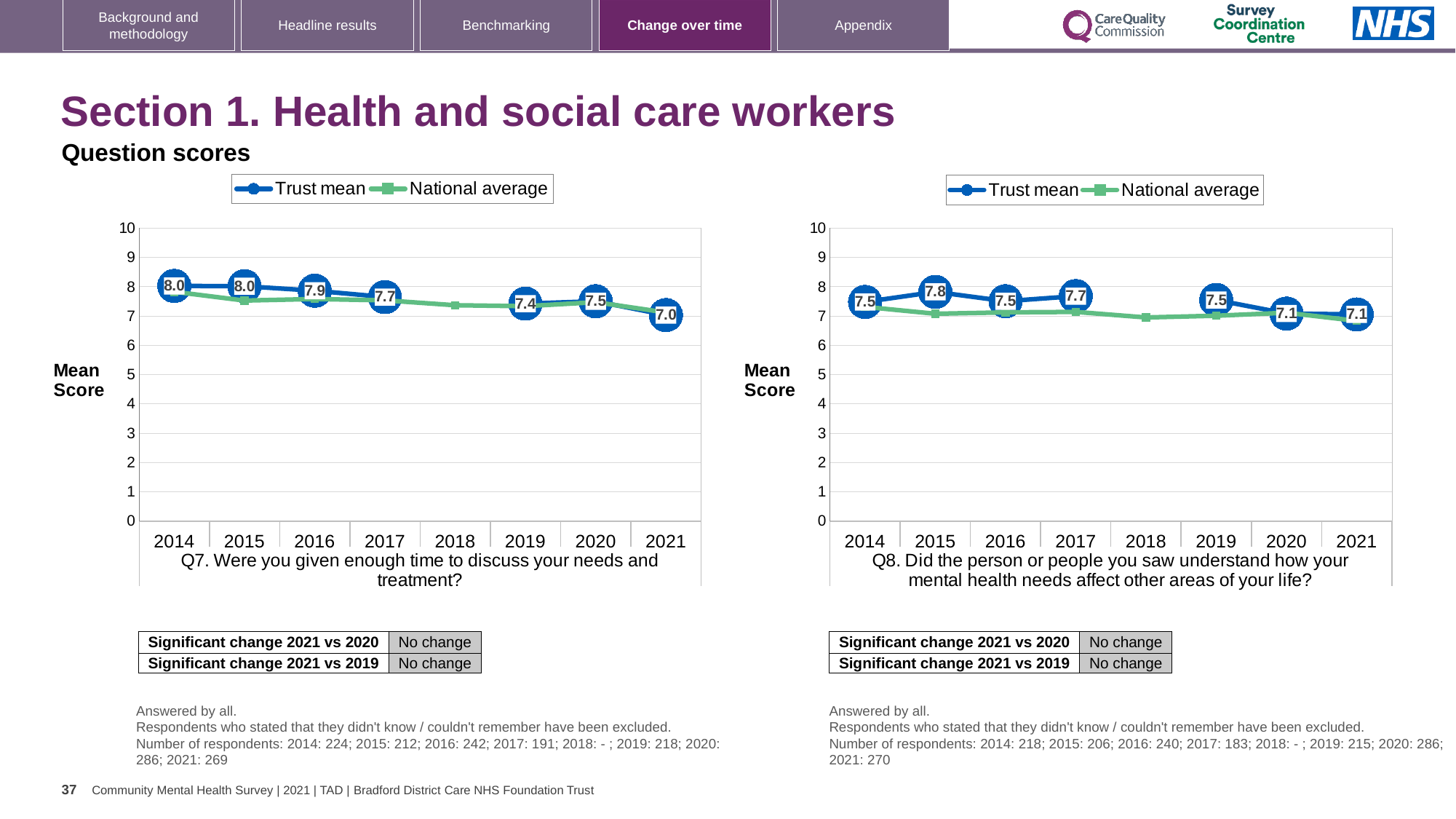
In the Q7 chart on the left, what is the Trust mean for 2021? 7.0 In the Q8 chart on the right, what is the Trust mean for 2015? 7.8 In the Q8 chart on the right, which year has the highest Trust mean? 2015 In the Q7 chart on the left, what is the Trust mean for 2014? 8.0 In the Q7 chart on the left, is the National average for 2018 greater or less than 8? less In the Q7 chart on the left, what is the difference between the Trust mean in 2014 and in 2021? 1.0 How many series does the legend of the Q7 chart on the left list? 2 In the Q8 chart on the right, which is larger, the Trust mean for 2017 or for 2019? 2017 What kind of chart is the Q7 chart on the left? Line chart How many years are shown on the x axis of the Q8 chart on the right? 8 In the Q7 chart on the left, which year has the lowest Trust mean? 2021 In the Q8 chart on the right, what is the Trust mean for 2020? 7.1